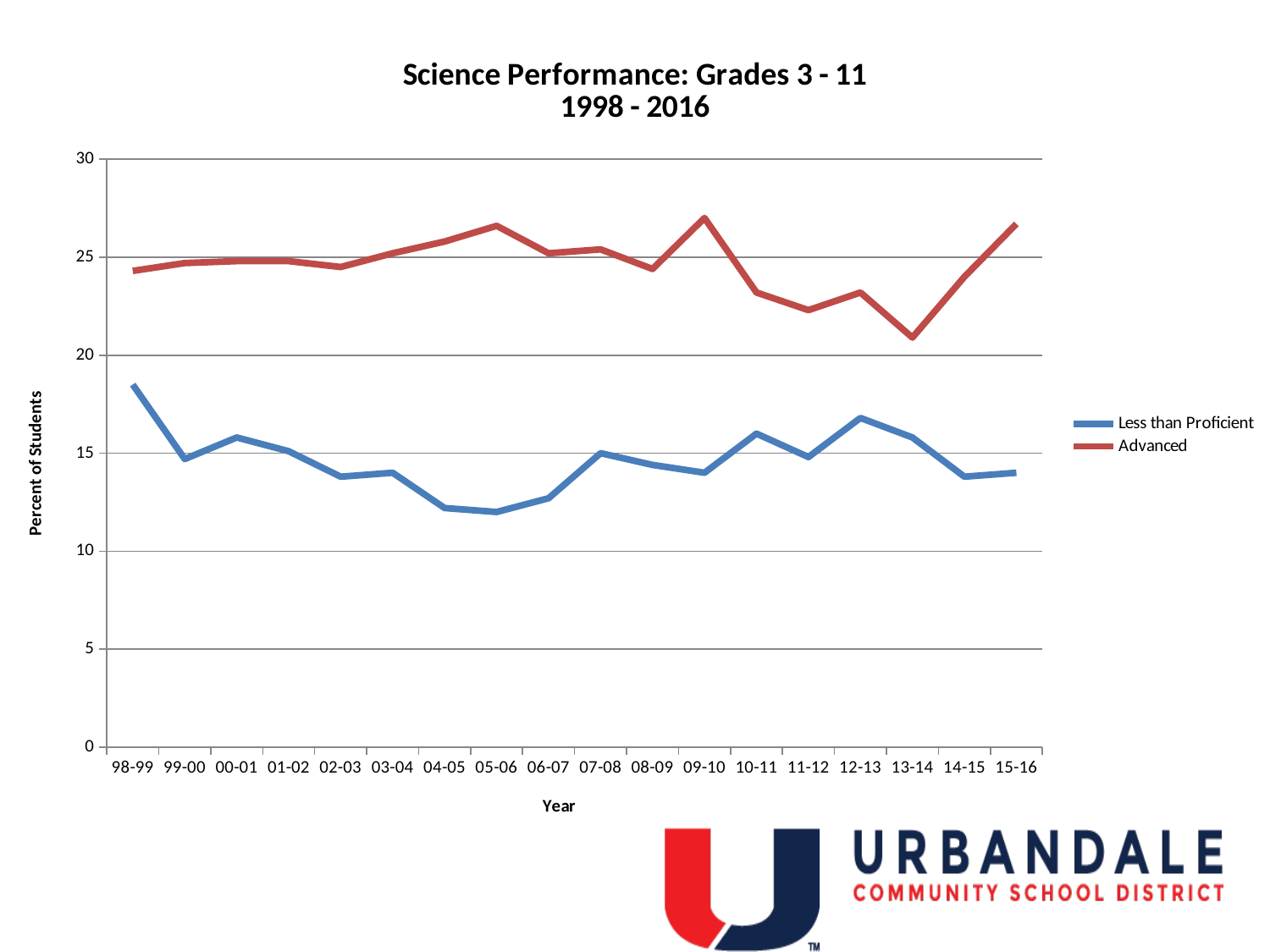
Is the value for Advanced in 09-10 greater or less than 25? greater Is the value for Advanced in 13-14 greater or less than 20? greater How many series does the legend list? 2 Which year has the highest value for the Less than Proficient series? 98-99 What kind of chart is shown on the slide? Line chart How many school years are plotted along the x axis? 18 Which year has the lowest value for the Advanced series? 13-14 Is the value for Less than Proficient in 05-06 greater or less than 15? less Does the Advanced series rise or fall from 13-14 to 15-16? Rise In 15-16, which series has the larger value, Advanced or Less than Proficient? Advanced What is the label of the y axis? Percent of Students